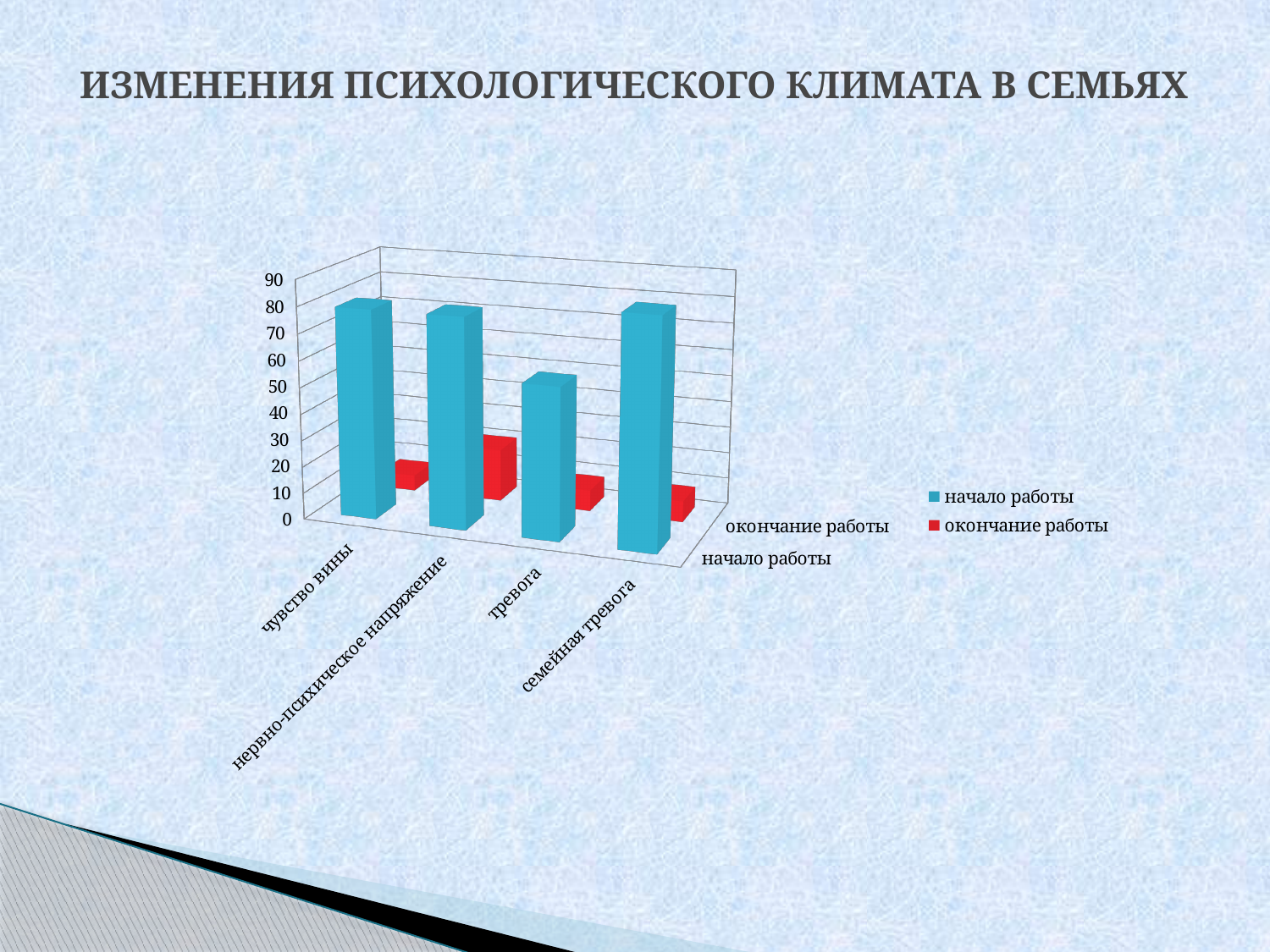
Is the value for 'тревога' in the series 'начало работы' greater or less than 70? less Which category has the lowest value for the series 'начало работы'? тревога How many series does the chart legend list? 2 Is the value for 'семейная тревога' in the series 'начало работы' greater or less than 50? greater Is the value for 'нервно-психическое напряжение' in the series 'окончание работы' greater or less than 40? less In the series 'начало работы', which is larger: 'чувство вины' or 'тревога'? чувство вины What is the title of the chart on the slide? ИЗМЕНЕНИЯ ПСИХОЛОГИЧЕСКОГО КЛИМАТА В СЕМЬЯХ For the category 'тревога', which series has the larger value: 'начало работы' or 'окончание работы'? начало работы What kind of chart is shown on the slide? bar chart Which colour represents the series 'окончание работы' in the chart? red How many categories are shown on the x axis of the chart? 4